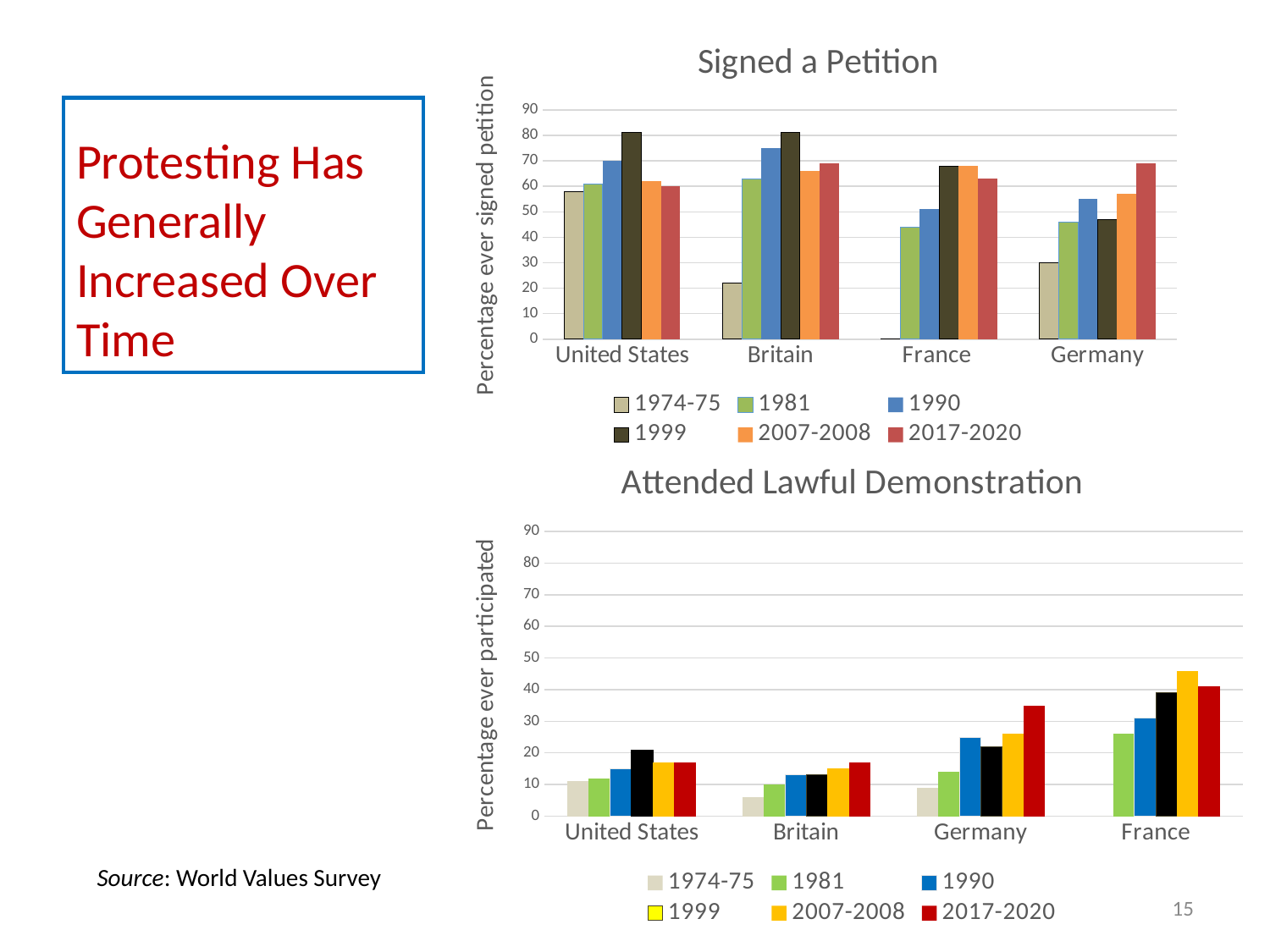
In the 'Attended Lawful Demonstration' chart, which is larger for 2007-2008: France or Germany? France In the 'Signed a Petition' chart, is the 1999 value for the United States greater or less than 70? greater In the 'Signed a Petition' chart, is the 1974-75 value for Britain greater or less than 30? less How many series does the legend of the 'Signed a Petition' chart list? 6 In the 'Attended Lawful Demonstration' chart, which survey wave has the highest value for France? 2007-2008 In the 'Attended Lawful Demonstration' chart, is the 1974-75 value for Britain greater or less than 10? less In the 'Signed a Petition' chart, which survey wave has the lowest value for Germany? 1974-75 In the 'Signed a Petition' chart, which survey wave has the highest value for Germany? 2017-2020 How many countries are shown on the x axis of the 'Attended Lawful Demonstration' chart? 4 What kind of chart is the 'Signed a Petition' chart? bar chart What is the y-axis label of the 'Attended Lawful Demonstration' chart? Percentage ever participated